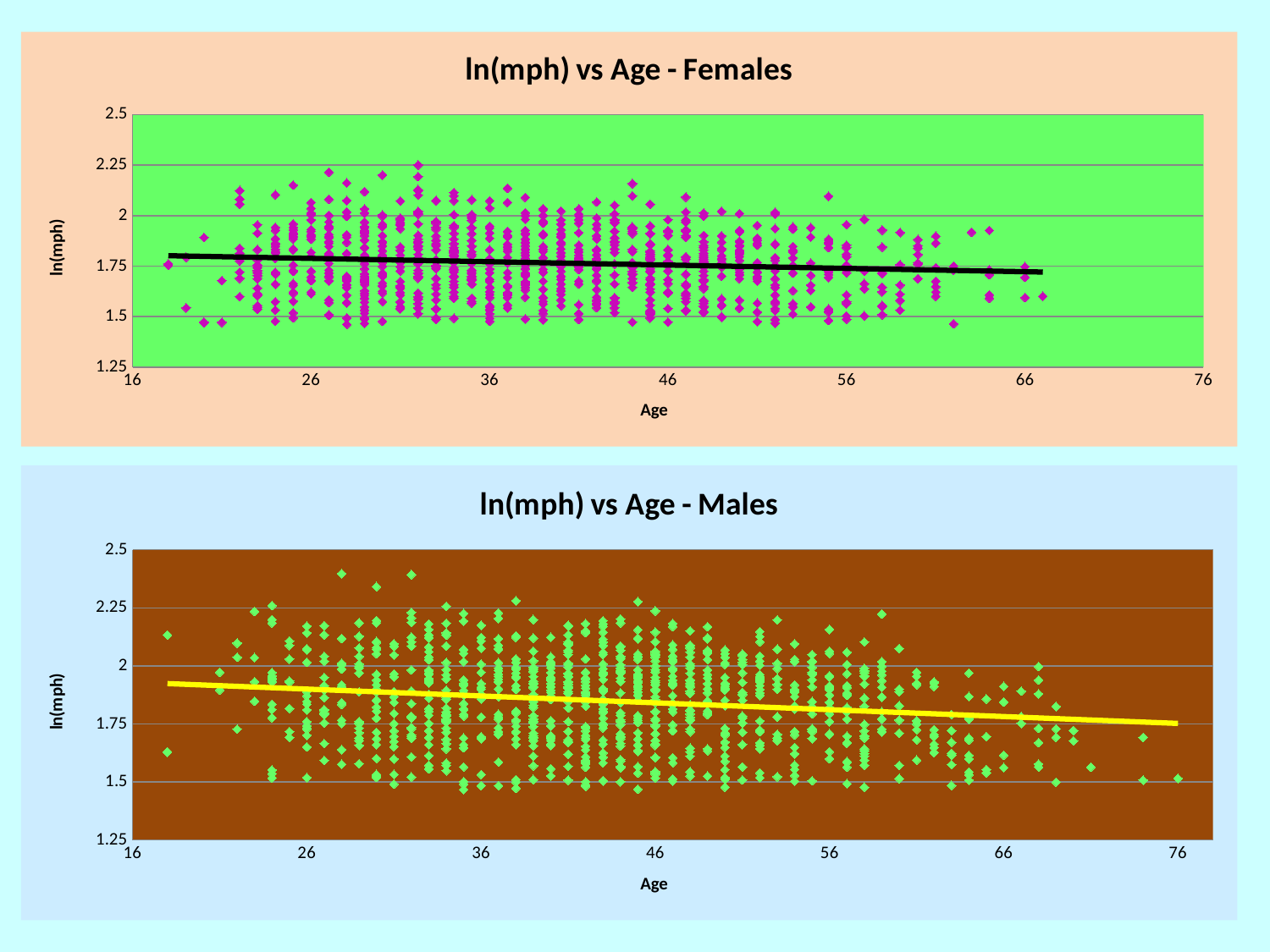
In the 'ln(mph) vs Age - Females' chart, is the trend line value at Age 18 greater or less than 2? less In the 'ln(mph) vs Age - Females' chart, is the trend line value at Age 18 greater or less than the trend line value at Age 66? greater In the 'ln(mph) vs Age - Males' chart, is the trend line value at Age 18 greater or less than 1.75? greater What kind of chart is the 'ln(mph) vs Age - Males' chart? scatter chart What is the label of the x axis on the 'ln(mph) vs Age - Males' chart? Age What kind of chart is the 'ln(mph) vs Age - Females' chart? scatter chart In the 'ln(mph) vs Age - Males' chart, is the trend line value at Age 18 greater or less than the trend line value at Age 76? greater In the 'ln(mph) vs Age - Males' chart, does the trend line rise or fall as Age increases? fall In the 'ln(mph) vs Age - Females' chart, does the trend line rise or fall as Age increases? fall What colour is the trend line in the 'ln(mph) vs Age - Males' chart? yellow In the 'ln(mph) vs Age - Females' chart, is the trend line value at Age 66 greater or less than 2? less